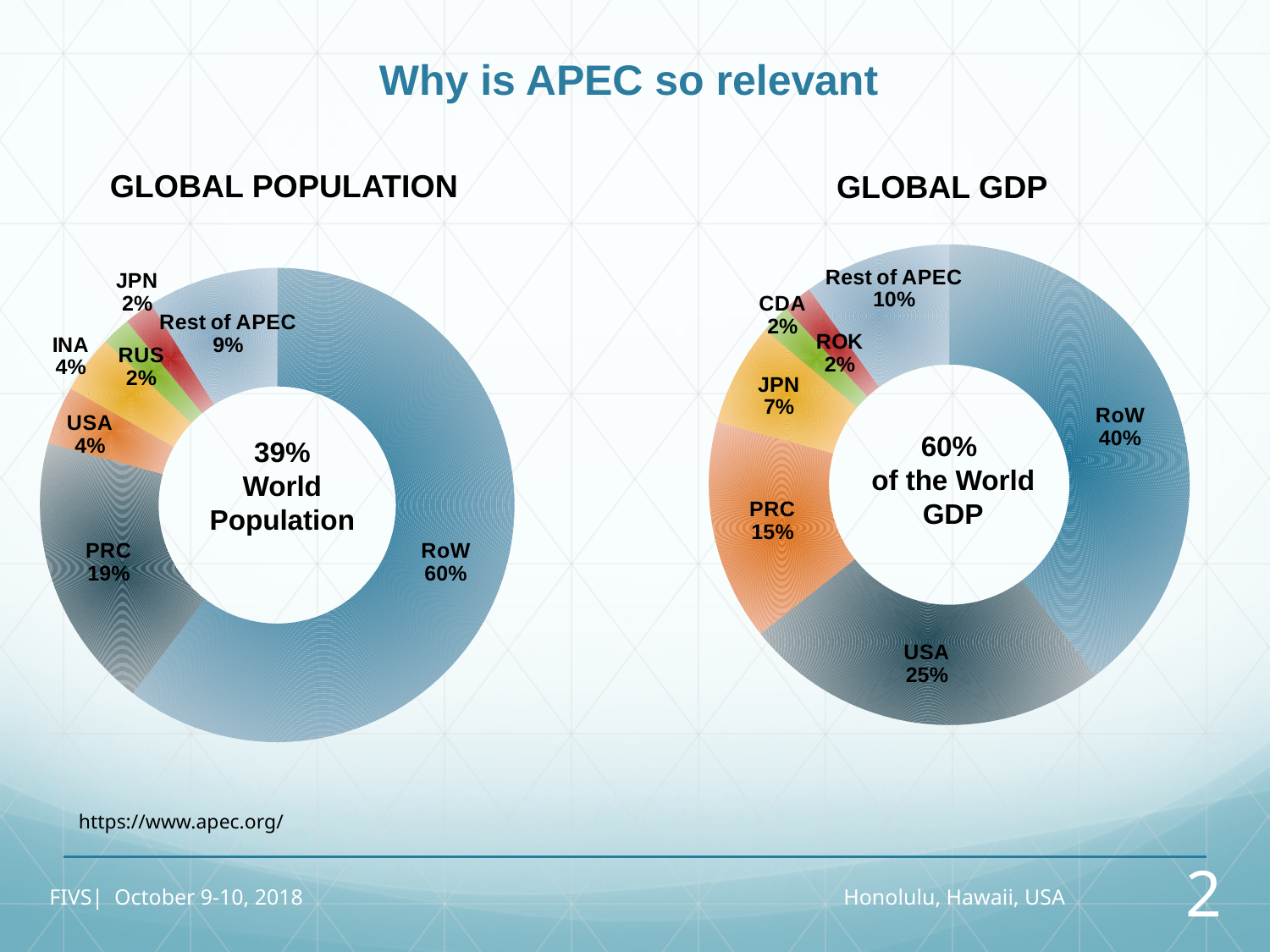
In the Global Population chart, which is larger, the share for Rest of APEC or the share for USA? Rest of APEC In the Global GDP chart, which category has the largest share? RoW In the Global Population chart, which category has the largest share? RoW In the Global GDP chart, what share does JPN hold? 7% In the Global GDP chart, which is larger, the share for PRC or the share for JPN? PRC How many categories are shown in the Global GDP chart? 7 In the Global Population chart, what share does PRC hold? 19% What text is shown in the centre of the Global GDP chart? 60% of the World GDP What kind of chart is the Global Population chart? Donut (pie) chart In the Global GDP chart, what share does USA hold? 25% In the Global Population chart, what is the difference between the RoW share and the PRC share? 41% In the Global GDP chart, what is the difference between the USA share and the PRC share? 10%